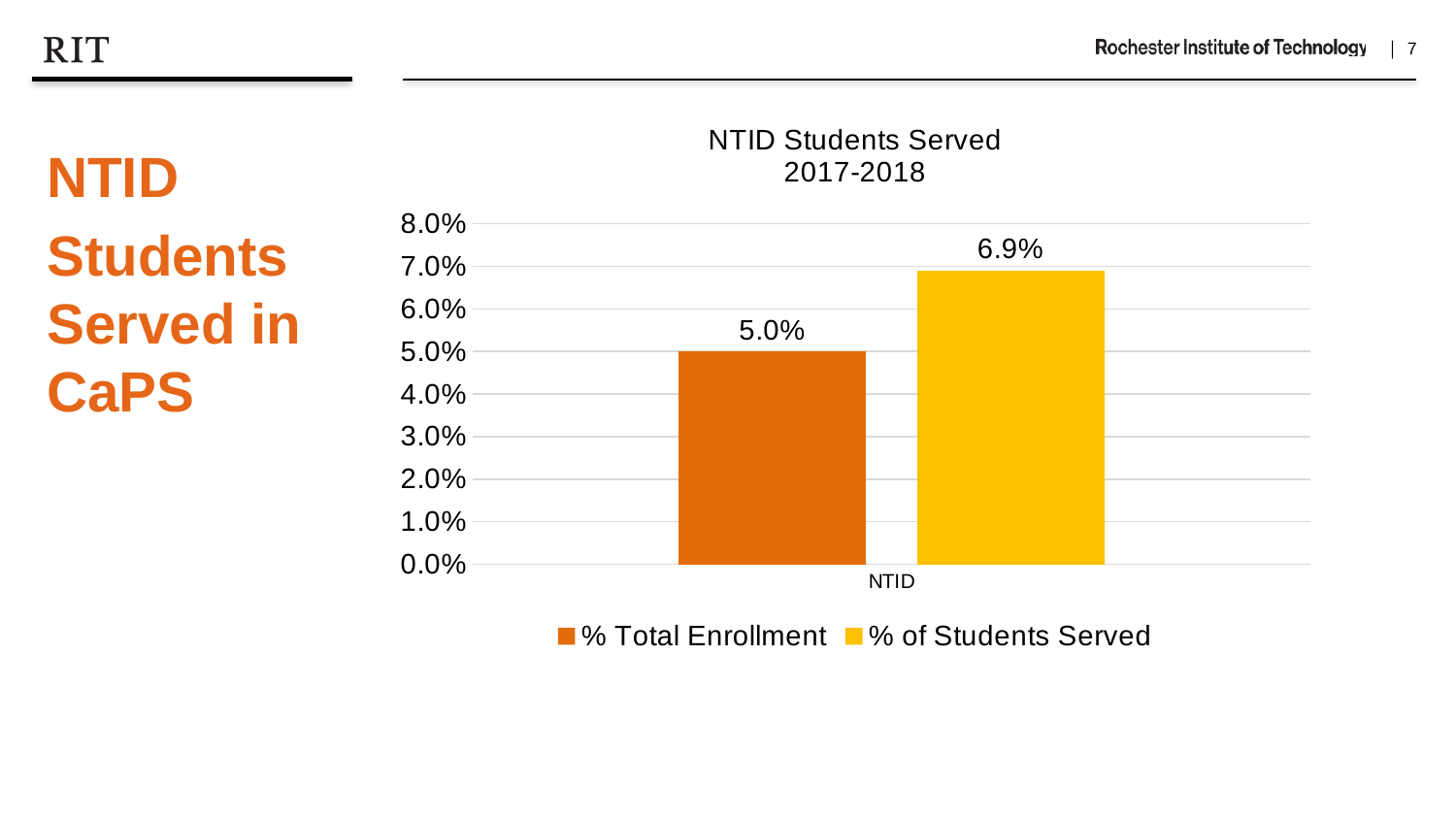
What is the title of the chart? NTID Students Served 2017-2018 What colour is the bar for % of Students Served? Yellow Which series has the higher value for NTID, % Total Enrollment or % of Students Served? % of Students Served How many series does the legend list? 2 What is the difference between % of Students Served and % Total Enrollment for NTID? 1.9% What kind of chart is shown on the slide? Bar chart Is the value for % of Students Served greater or less than 6.0%? greater How many categories are shown on the x axis? 1 Is the value for % Total Enrollment greater or less than 6.0%? less What is the value of % of Students Served for NTID? 6.9% What is the value of % Total Enrollment for NTID? 5.0% What is the highest value shown on the y axis? 8.0%